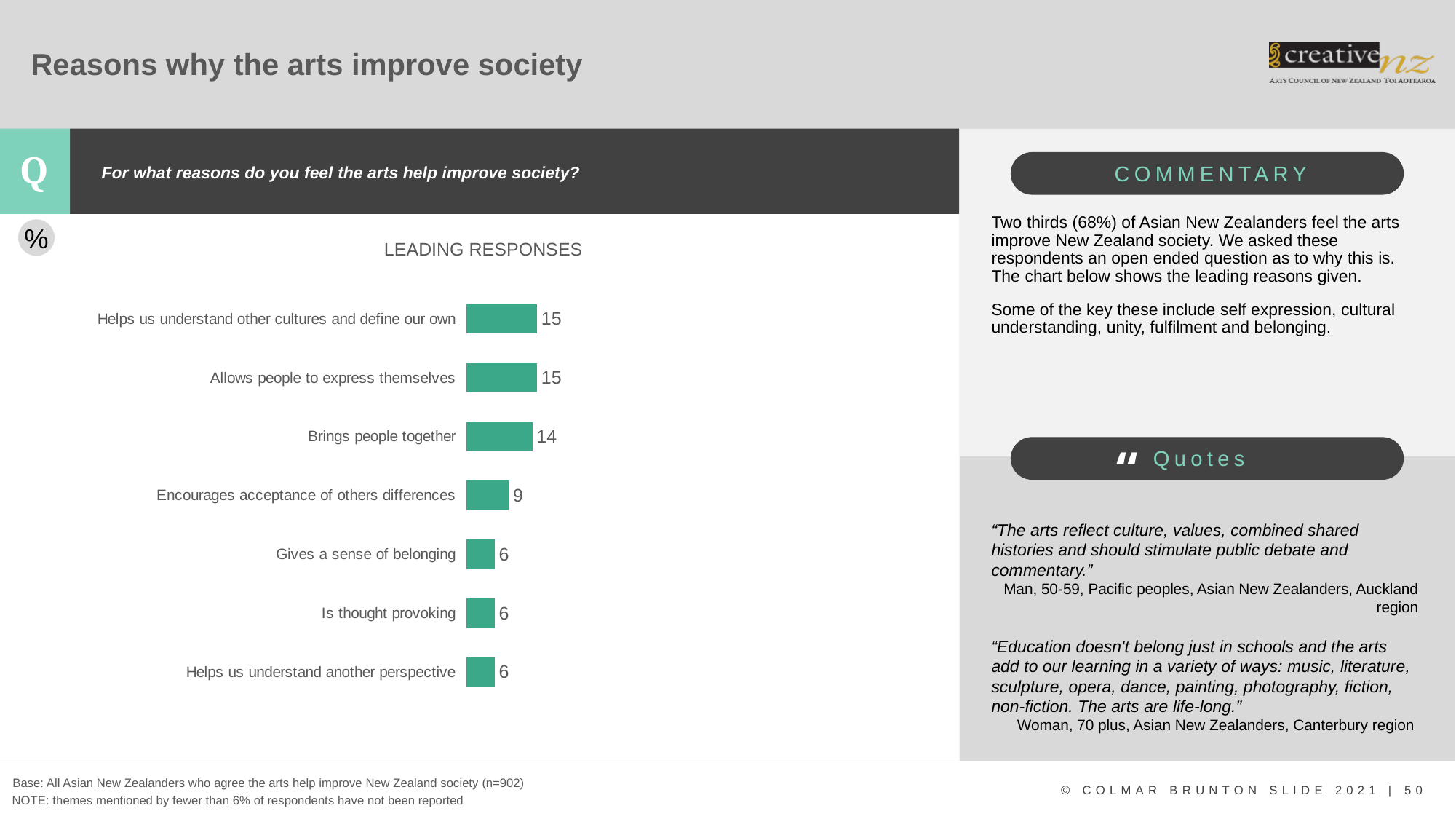
How many categories have a value of 6? 3 What is the value for "Allows people to express themselves"? 15 What is the difference between the values for "Brings people together" and "Is thought provoking"? 8 What is the value for "Is thought provoking"? 6 What is the value for "Gives a sense of belonging"? 6 What is the value for "Encourages acceptance of others differences"? 9 Which is larger, the value for "Encourages acceptance of others differences" or the value for "Helps us understand another perspective"? Encourages acceptance of others differences What is the value for "Brings people together"? 14 How many categories are shown in the chart? 7 What kind of chart is shown on the slide? Bar chart What is the difference between the values for "Helps us understand other cultures and define our own" and "Brings people together"? 1 What is the title of the chart? LEADING RESPONSES